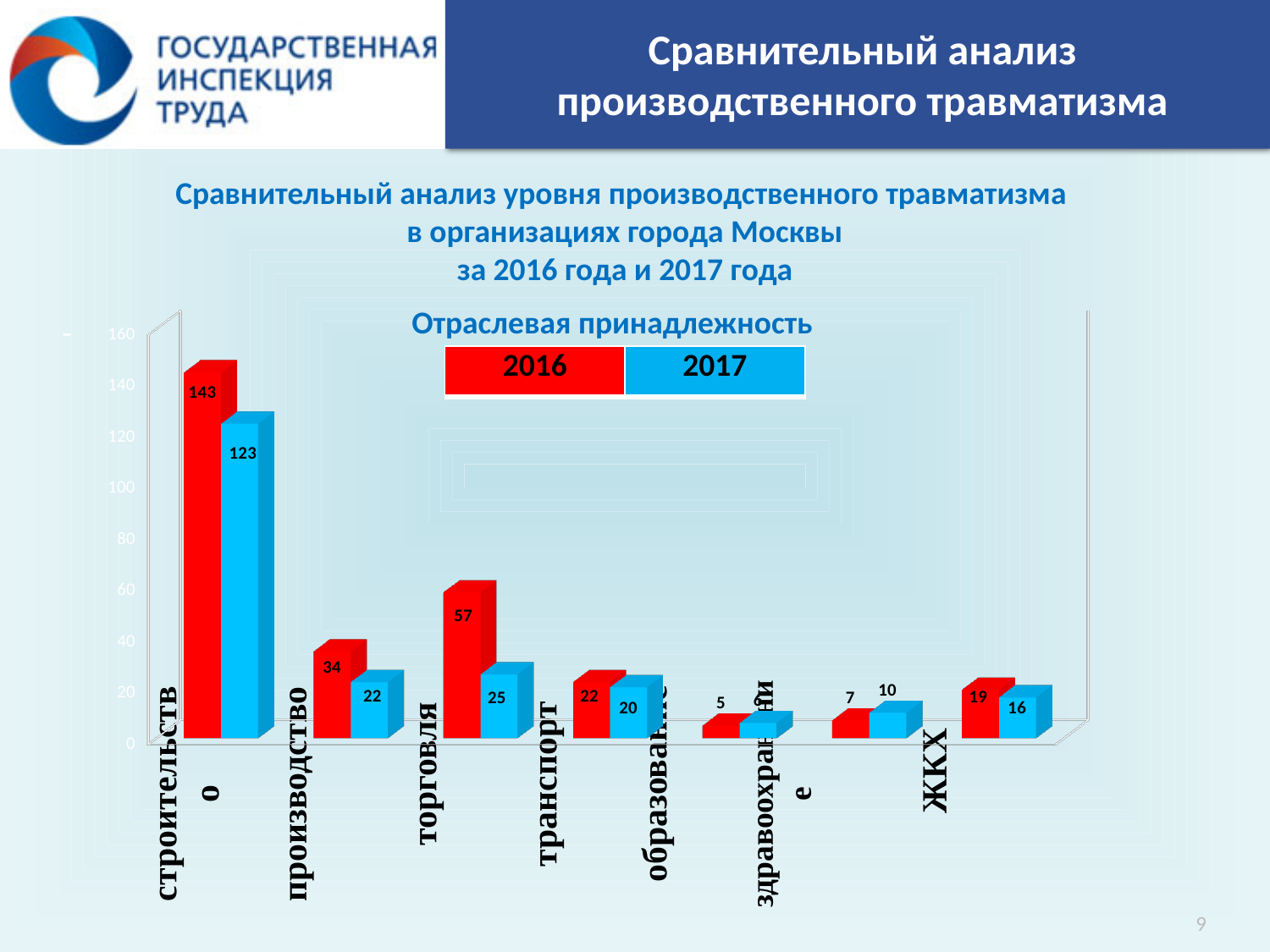
What is the difference between the 2016 and 2017 values for торговля? 32 What is the difference between the 2016 and 2017 values for строительство? 20 What is the 2017 value for здравоохранение? 10 Which category has the lowest 2016 value? образование What is the 2016 value for строительство? 143 What kind of chart is shown on the slide? bar chart How many series does the legend list? 2 Is the 2017 value for строительство greater or less than 100? greater How many categories are shown on the x axis? 7 What is the 2017 value for торговля? 25 Which is larger for здравоохранение, the 2016 value or the 2017 value? 2017 Which category has the highest 2016 value? строительство